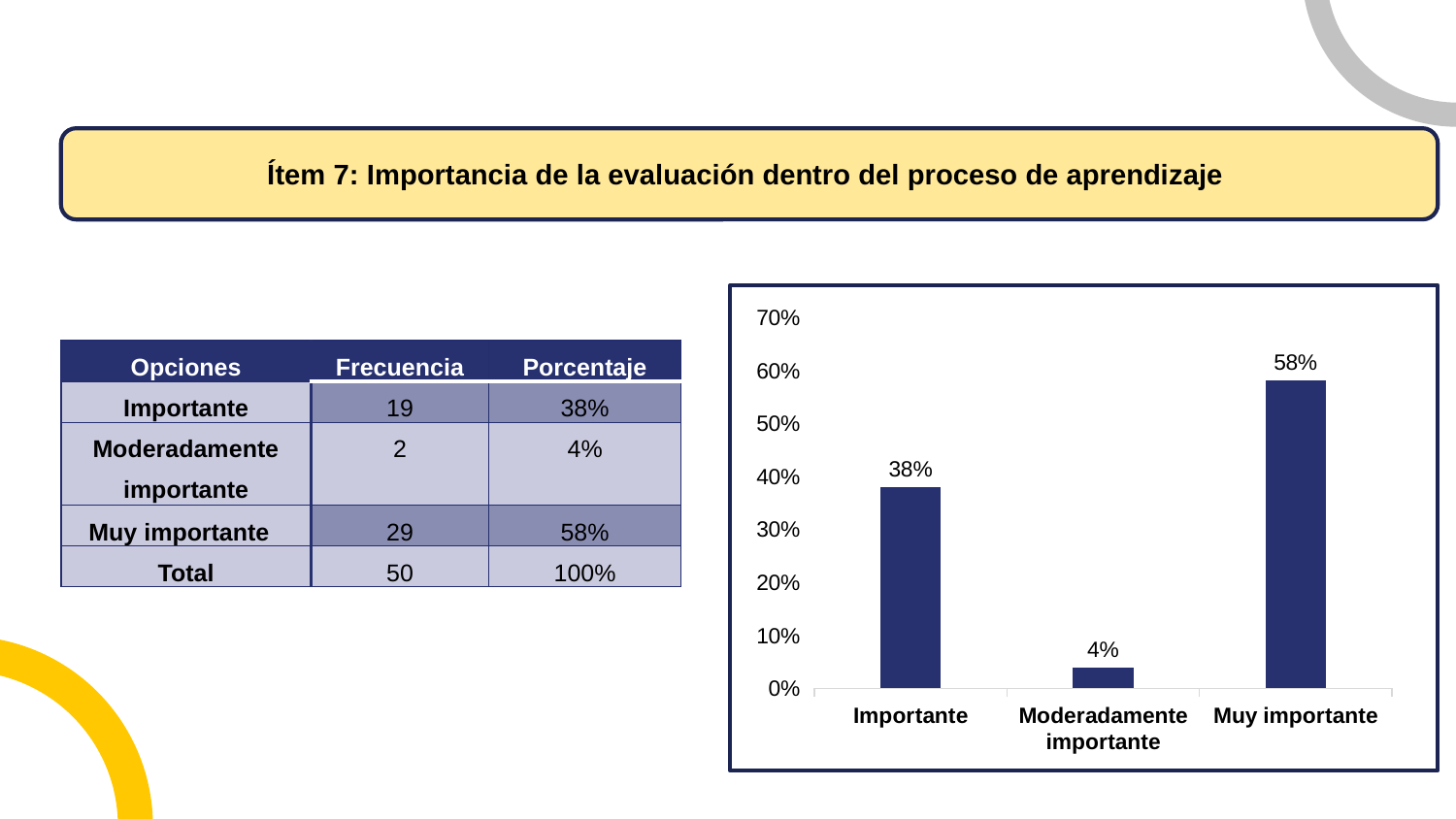
What is the value for Muy importante in the chart? 58% What kind of chart is shown on the slide? bar chart How many categories are shown on the x axis of the chart? 3 What is the value for Moderadamente importante in the chart? 4% What is the difference between the values for Importante and Moderadamente importante? 34% Which category has the highest value in the chart? Muy importante What is the difference between the values for Muy importante and Importante? 20% Is the value for Muy importante greater or less than 50%? greater Which category has the lowest value in the chart? Moderadamente importante Which is larger, the value for Importante or the value for Muy importante? Muy importante What is the highest value shown on the y axis of the chart? 70% What is the value for Importante in the chart? 38%